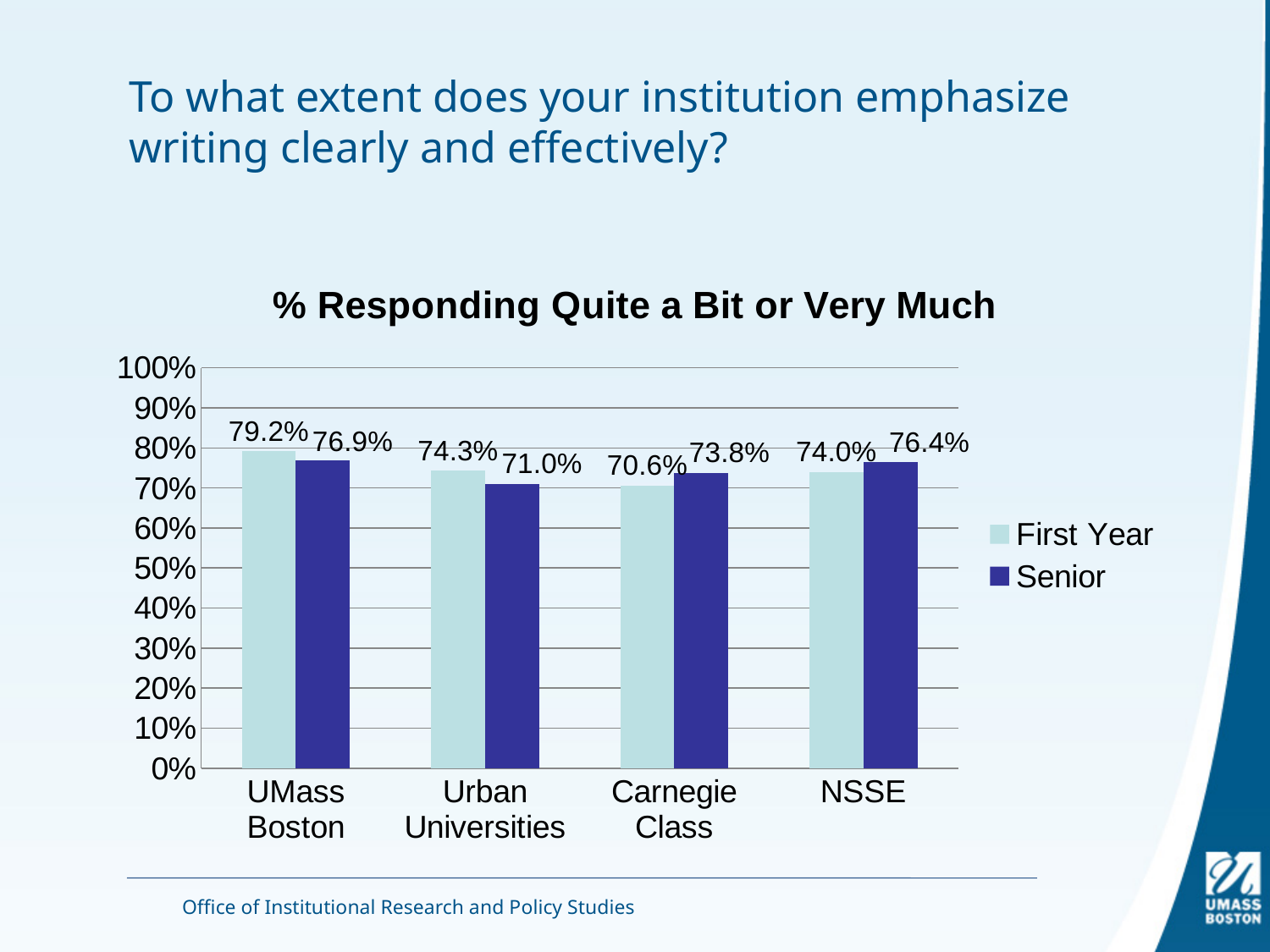
Which category has the highest First Year value? UMass Boston What is the difference between the First Year and Senior values for UMass Boston? 2.3% Which category has the lowest Senior value? Urban Universities Is the First Year value for Carnegie Class greater or less than 80%? less Which is larger for NSSE, the First Year value or the Senior value? Senior What is the title of the chart? % Responding Quite a Bit or Very Much What is the Senior value for Urban Universities? 71.0% What is the Senior value for Carnegie Class? 73.8% What kind of chart is shown on the slide? bar chart How many categories are shown on the x axis? 4 What is the First Year value for UMass Boston? 79.2% How many series does the legend list? 2